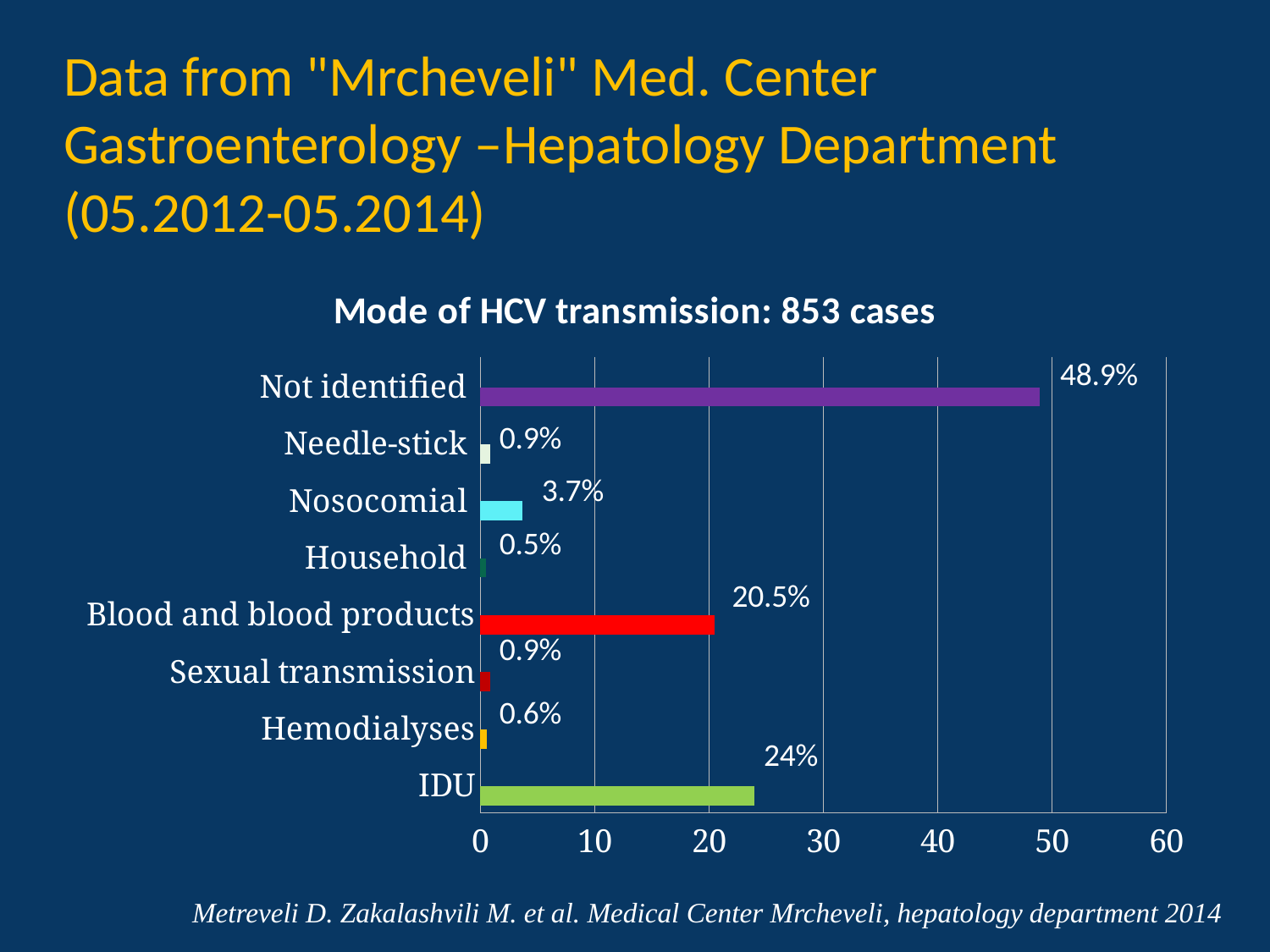
Which is larger, the value for Nosocomial or the value for Hemodialyses? Nosocomial What is the title of the chart? Mode of HCV transmission: 853 cases What is the value for IDU? 24% Is the value for Not identified greater or less than 40? greater What is the value for Not identified? 48.9% Which mode of transmission has the highest value? Not identified What is the difference between the values for IDU and Blood and blood products? 3.5% How many categories are shown in the chart? 8 What is the value for Nosocomial? 3.7% What is the value for Blood and blood products? 20.5% Which mode of transmission has the lowest value? Household What kind of chart is shown on the slide? Bar chart